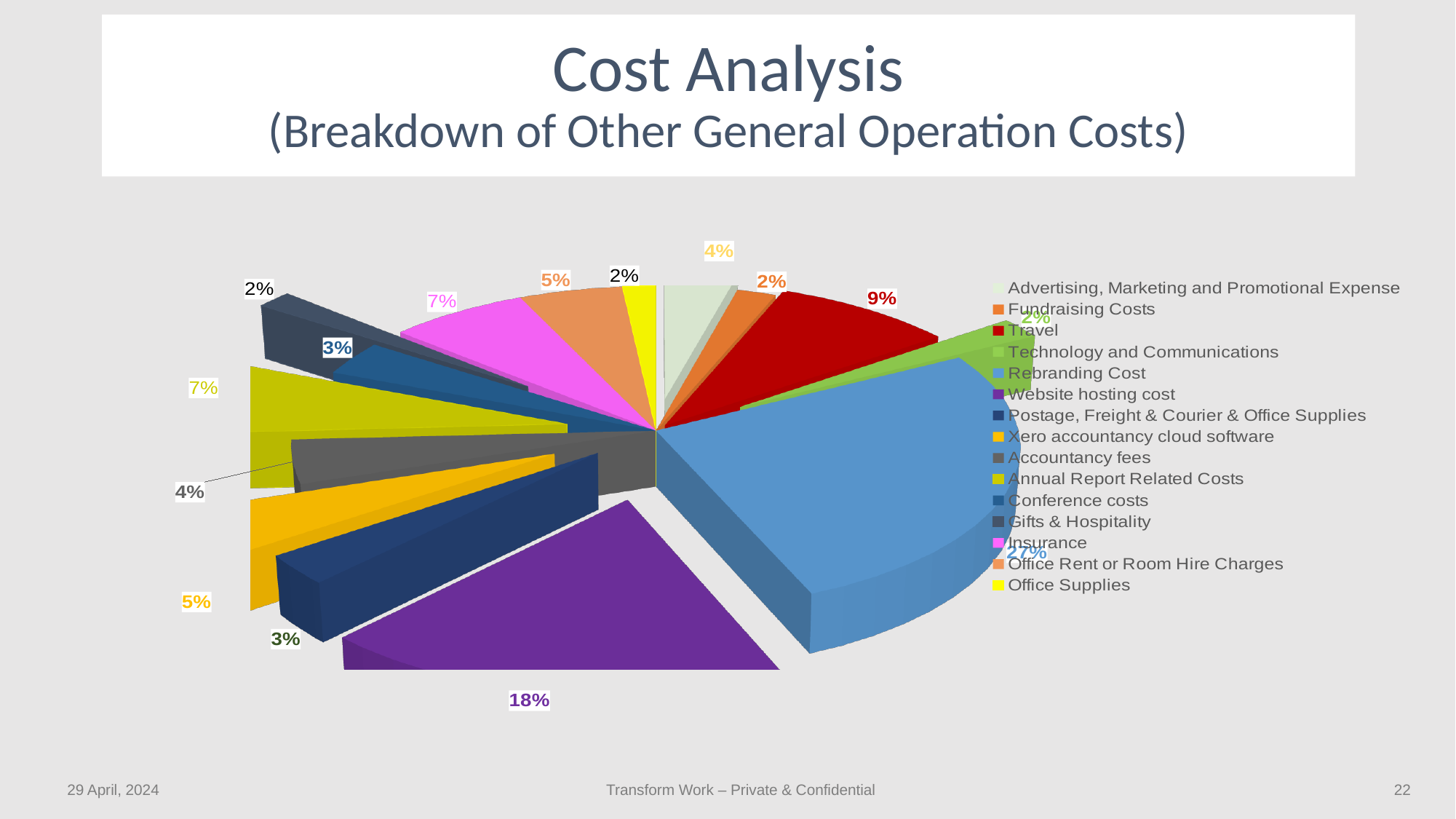
What percentage is shown for Website hosting cost? 18% What is the subtitle of the chart shown in parentheses under the main title? Breakdown of Other General Operation Costs What is the difference in percentage points between Rebranding Cost and Website hosting cost? 9 What share of the pie does Rebranding Cost account for? 27% What kind of chart is shown on the slide? Pie chart How many categories does the legend of the pie chart list? 15 What is the difference in percentage points between Travel and Office Rent or Room Hire Charges? 4 What percentage is shown for Travel? 9% What percentage is shown for Insurance? 7% What percentage is shown for Xero accountancy cloud software? 5% Which is larger, the share for Travel or the share for Insurance? Travel Which category has the largest share of the pie? Rebranding Cost